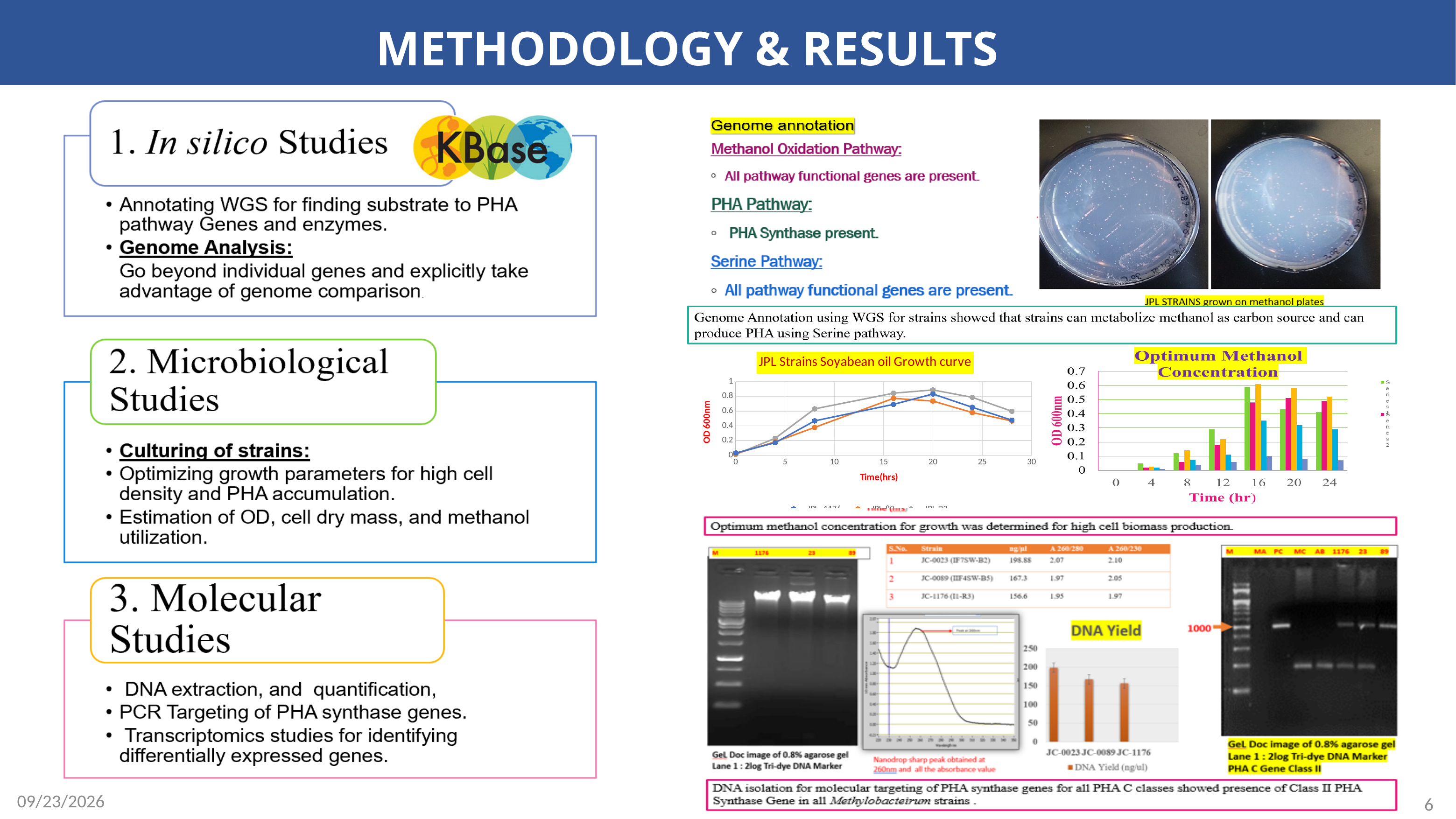
How many strains are shown in the 'DNA Yield' chart? 3 What is the x-axis label of the 'JPL Strains Soyabean oil Growth curve' chart? Time(hrs) How many time points are shown on the x axis of the 'Optimum Methanol Concentration' chart? 7 In the 'Optimum Methanol Concentration' chart, is the tallest bar at 16 hr greater or less than 0.5? greater What kind of chart is the 'DNA Yield' chart? bar chart In the 'JPL Strains Soyabean oil Growth curve' chart, is the highest value of the gray line greater or less than 0.8? greater What kind of chart is the 'JPL Strains Soyabean oil Growth curve' chart? line chart In the 'Optimum Methanol Concentration' chart, are the bars at 0 hr greater or less than 0.1? less In the 'DNA Yield' chart, which strain has the highest DNA yield? JC-0023 What is the y-axis label of the 'JPL Strains Soyabean oil Growth curve' chart? OD 600nm What kind of chart is the 'Optimum Methanol Concentration' chart? bar chart